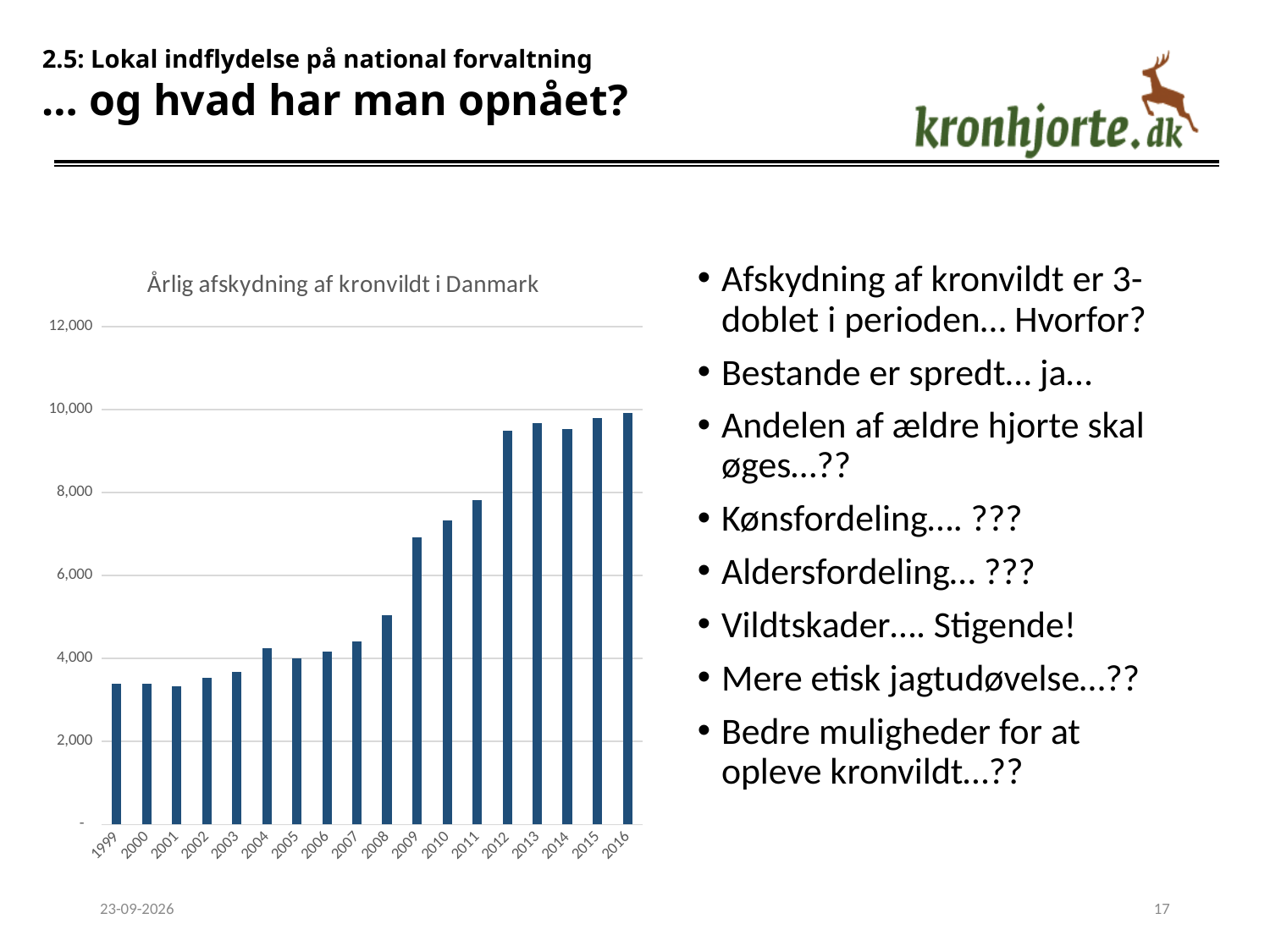
Which is the first year shown on the x axis of the chart? 1999 What kind of chart is shown on the slide? bar chart Is the value for 2008 greater or less than 4,000? greater Is the value for 2009 greater or less than 8,000? less Which year has the larger value, 2013 or 2007? 2013 How many years (bars) are shown in the chart? 18 Is the value for 2012 greater or less than 8,000? greater Do the values in the chart generally rise or fall from 1999 to 2016? rise What is the title of the chart? Årlig afskydning af kronvildt i Danmark Which year has the larger value, 2003 or 2009? 2009